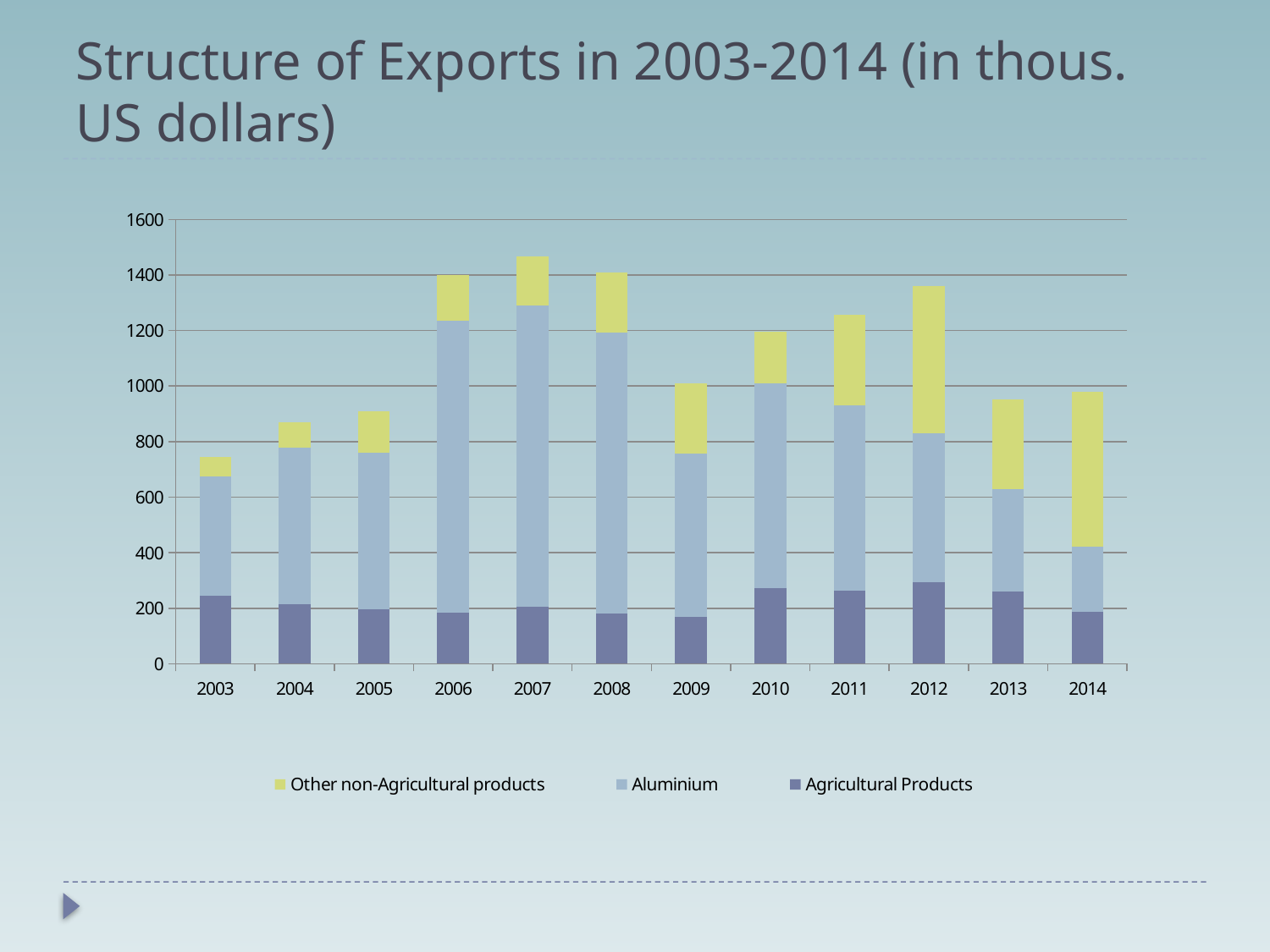
How many years are shown along the x axis of the chart? 12 Which year has the highest total exports in the chart? 2007 Is the total export value for 2007 greater or less than 1400? greater Which year has the larger total exports, 2006 or 2003? 2006 What kind of chart is shown on the slide? stacked bar chart Is the total export value for 2012 greater or less than 1200? greater Which series is shown in yellow in the chart? Other non-Agricultural products How many series does the chart's legend list? 3 Which year has the lowest total exports in the chart? 2003 Do total exports rise or fall from 2012 to 2014? fall Is the total export value for 2003 greater or less than 800? less